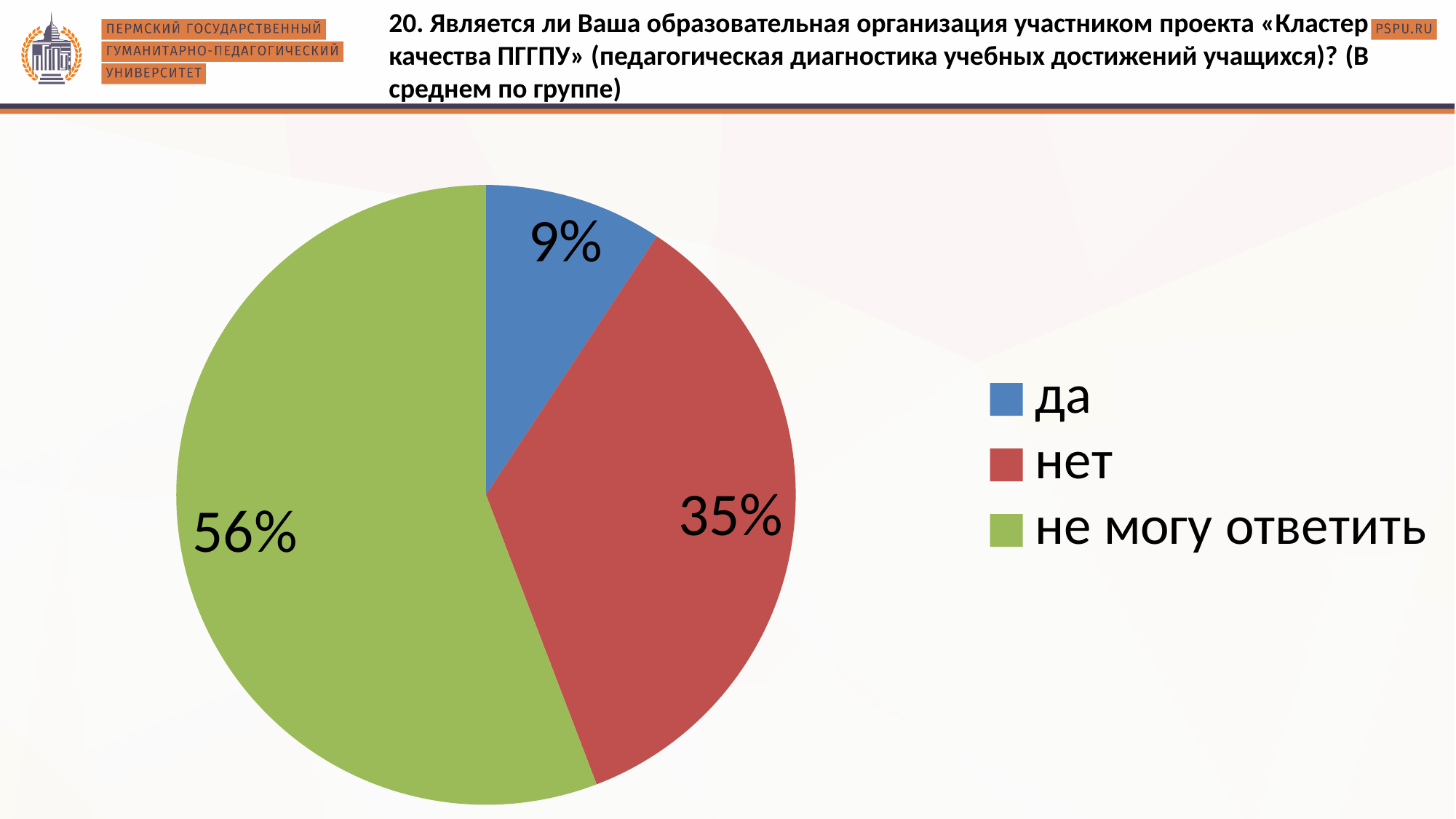
What share of the pie does the "не могу ответить" slice represent? 56% How many categories does the pie chart show? 3 What share of the pie does the "нет" slice represent? 35% What share of the pie does the "да" slice represent? 9% What colour is the "нет" slice in the pie chart? red Which legend entry is shown in green? не могу ответить Which slice is larger, "да" or "нет"? нет Which category has the largest slice of the pie? не могу ответить What kind of chart is shown on the slide? pie chart What is the difference in percentage points between the "нет" slice and the "да" slice? 26 Which category has the smallest slice of the pie? да What is the difference in percentage points between the "не могу ответить" slice and the "нет" slice? 21